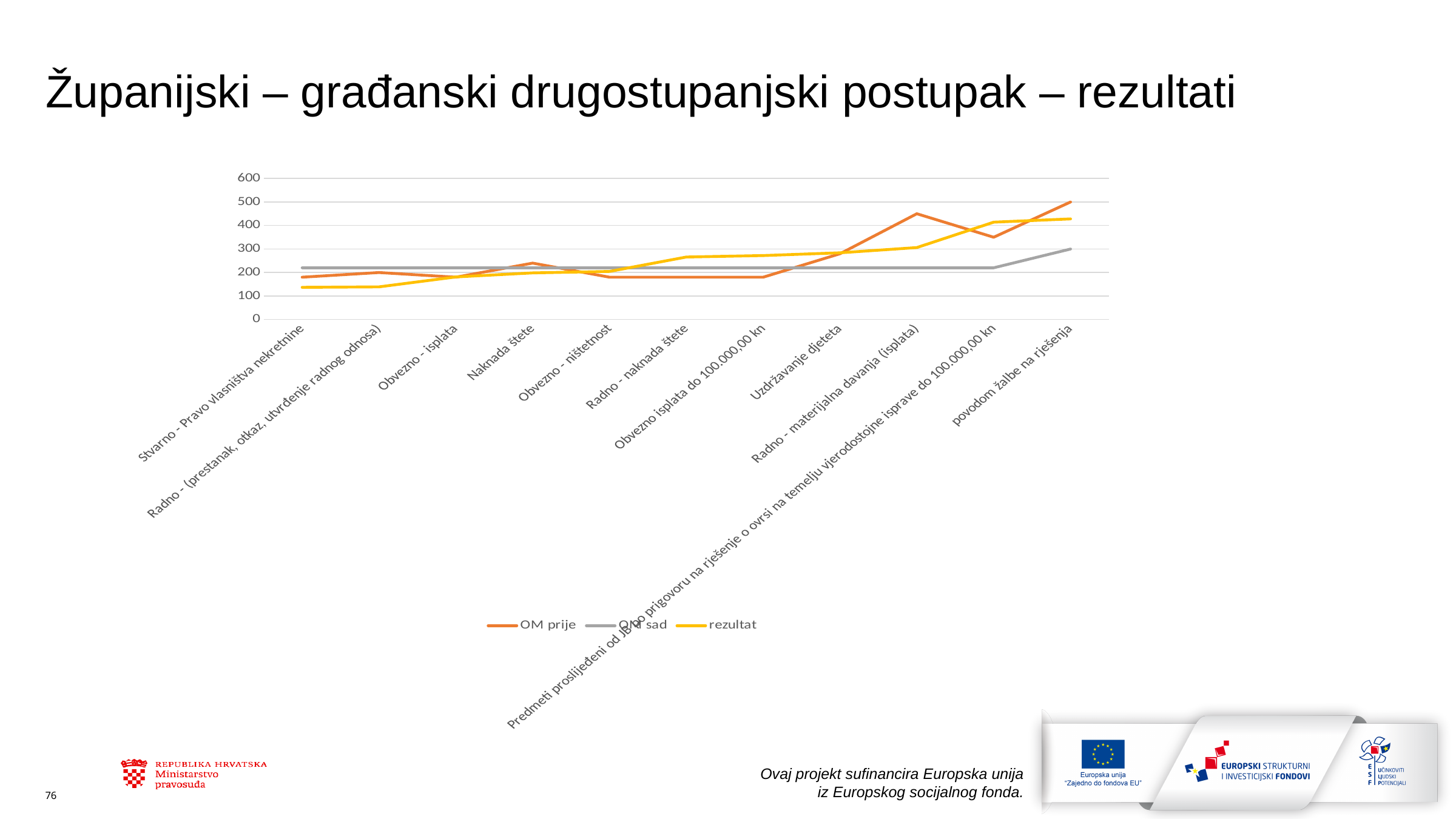
For 'povodom žalbe na rješenja', which series has the larger value, OM prije or OM sad? OM prije For which category does the OM prije series reach its highest value? povodom žalbe na rješenja Does the rezultat series generally rise or fall from left to right along the x axis? Rise Is the value of OM sad for 'povodom žalbe na rješenja' greater or less than 400? less Is the value of OM prije for 'Radno - materijalna davanja (isplata)' greater or less than 400? greater How many series does the legend list? 3 How many categories are plotted along the x axis? 11 What kind of chart is shown on the slide? Line chart What are the three series named in the legend? OM prije, OM sad, rezultat Is the value of OM sad for 'Stvarno - Pravo vlasništva nekretnine' greater or less than 300? less